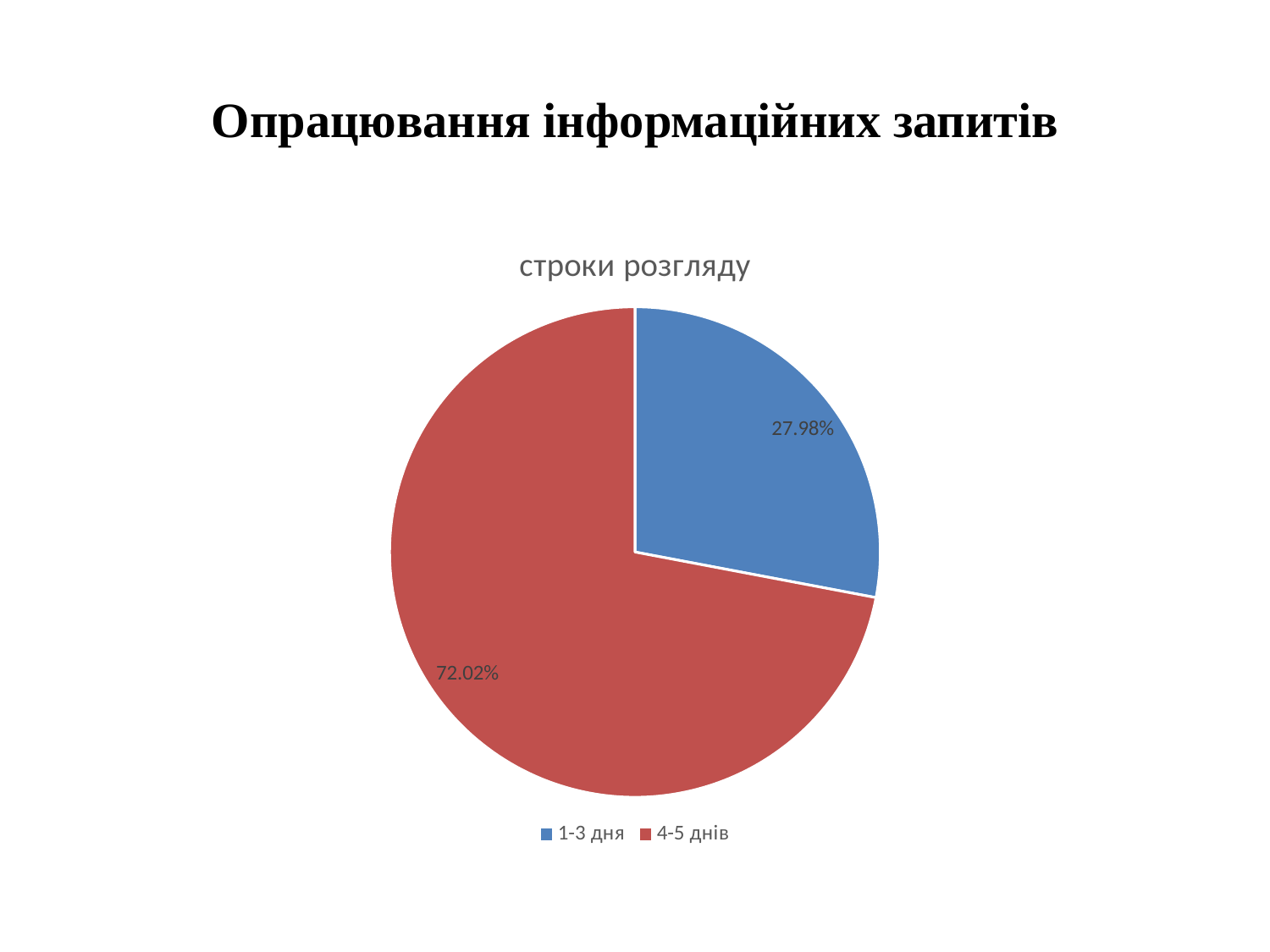
What is the title of the chart? строки розгляду Which slice is larger, "1-3 дня" or "4-5 днів"? 4-5 днів How many entries does the legend list? 2 Which category has the largest slice of the pie? 4-5 днів Which colour represents the "4-5 днів" category? Red What share of the pie does the "4-5 днів" slice represent? 72.02% Which category has the smallest slice of the pie? 1-3 дня How many categories are shown in the pie chart? 2 What kind of chart is shown on the slide? Pie chart What is the difference in percentage points between the "4-5 днів" and "1-3 дня" slices? 44.04 What share of the pie does the "1-3 дня" slice represent? 27.98%